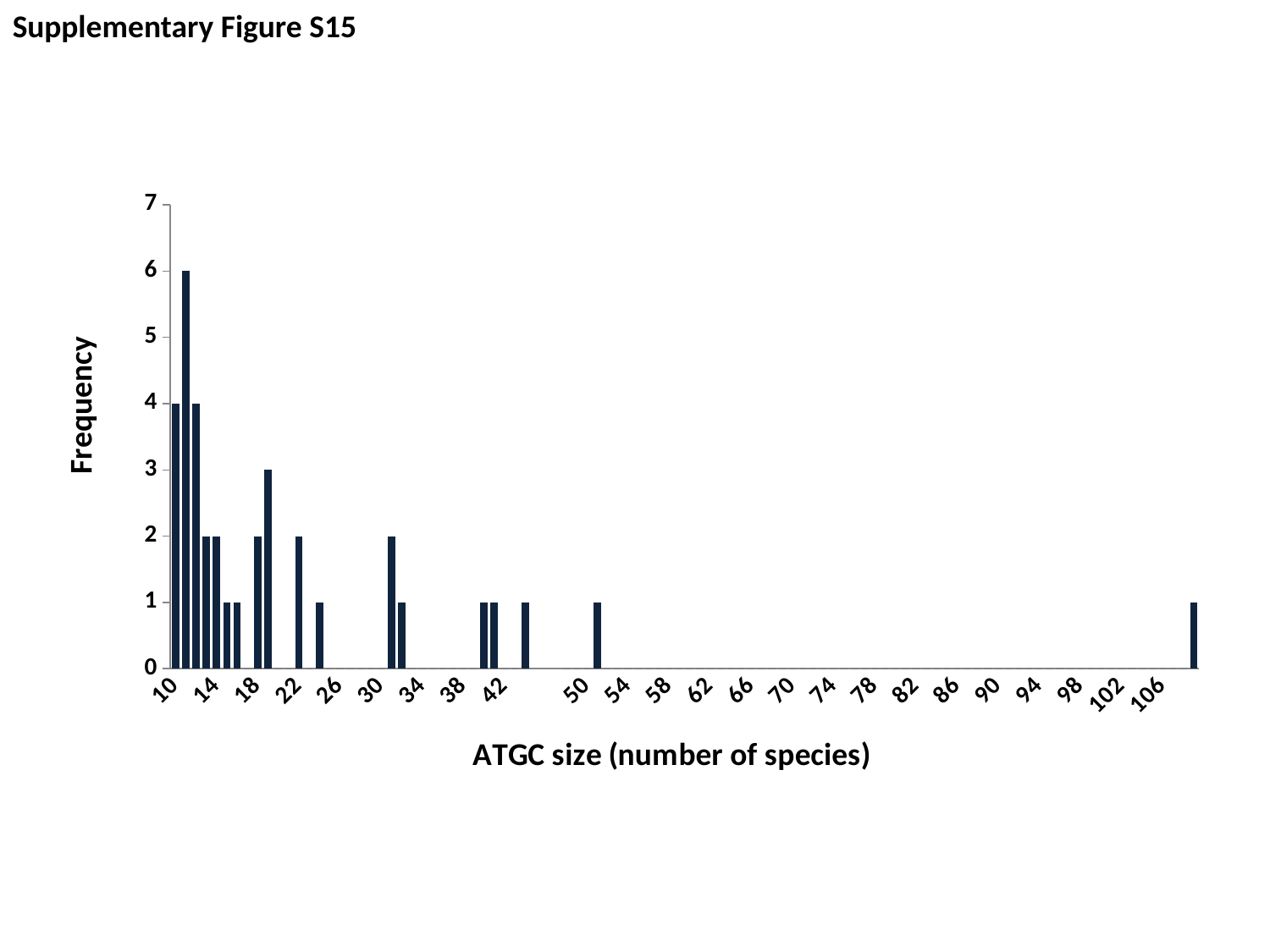
What is the label of the y axis? Frequency Which has the higher frequency, ATGC size 10 or ATGC size 14? ATGC size 10 What is the frequency for ATGC size 22? 2 What is the difference in frequency between ATGC size 10 and ATGC size 14? 2 Is the frequency of the tallest bar greater or less than 5? greater What is the frequency for ATGC size 18? 2 What type of chart is shown on the slide? bar chart What is the label of the x axis? ATGC size (number of species) What is the frequency for ATGC size 14? 2 What is the frequency for ATGC size 10? 4 Do the frequencies generally rise or fall as ATGC size increases along the x axis? fall What is the highest frequency reached by any bar in the chart? 6